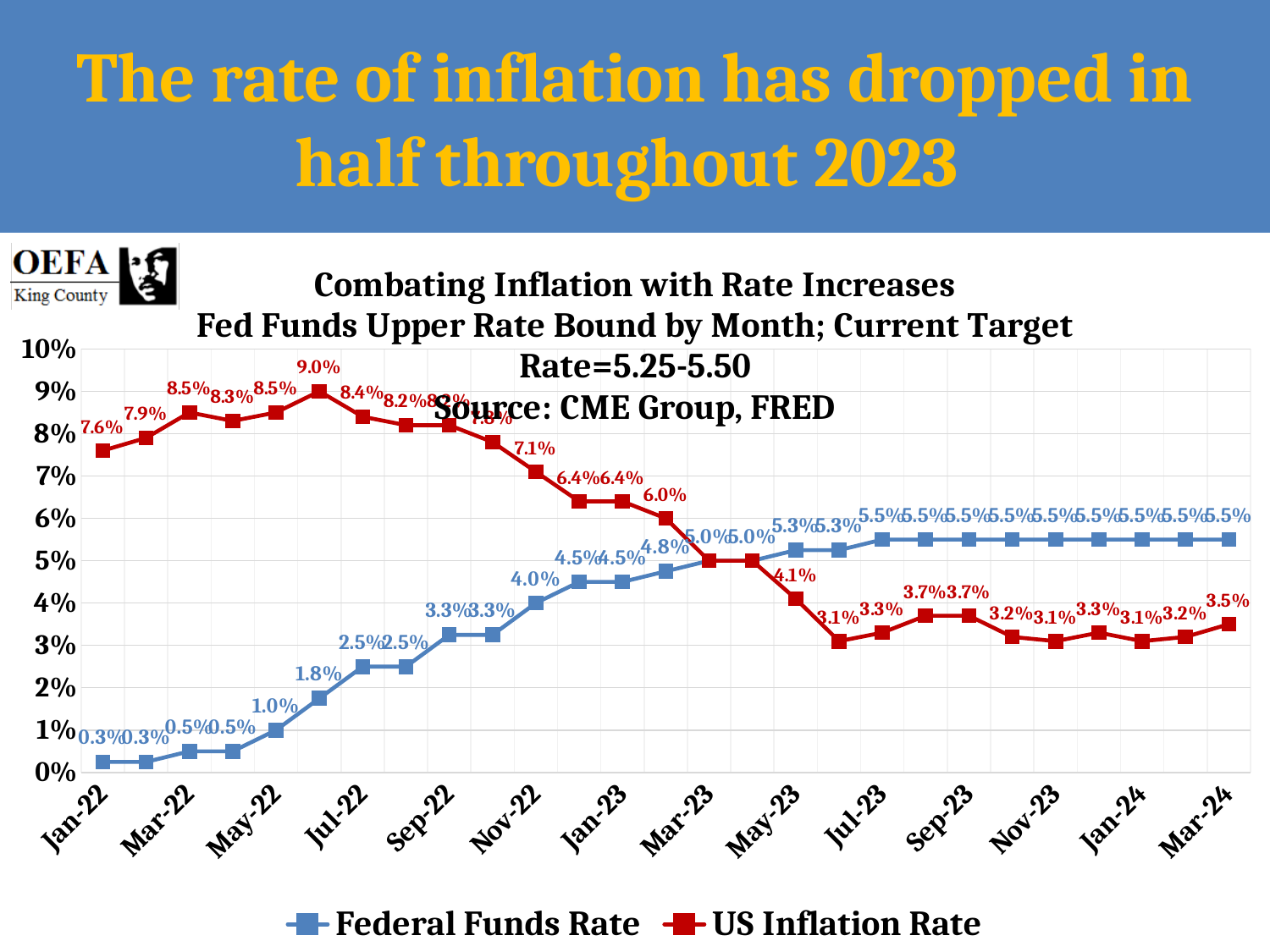
Does the Federal Funds Rate generally rise or fall from Jan-22 to Mar-24? rise What is the highest value plotted for the US Inflation Rate? 9.0% What is the US Inflation Rate for Jan-22? 7.6% What is the Federal Funds Rate for Jul-22? 2.5% In Jan-22, which is higher: the Federal Funds Rate or the US Inflation Rate? US Inflation Rate Which colour represents the Federal Funds Rate in the legend? blue What is the difference between the US Inflation Rate and the Federal Funds Rate in Mar-24? 2.0 percentage points What kind of chart is shown on the slide? line chart What is the Federal Funds Rate for Jan-22? 0.3% What is the lowest value plotted for the Federal Funds Rate? 0.3% What is the US Inflation Rate for Mar-24? 3.5% How many series does the legend list? 2